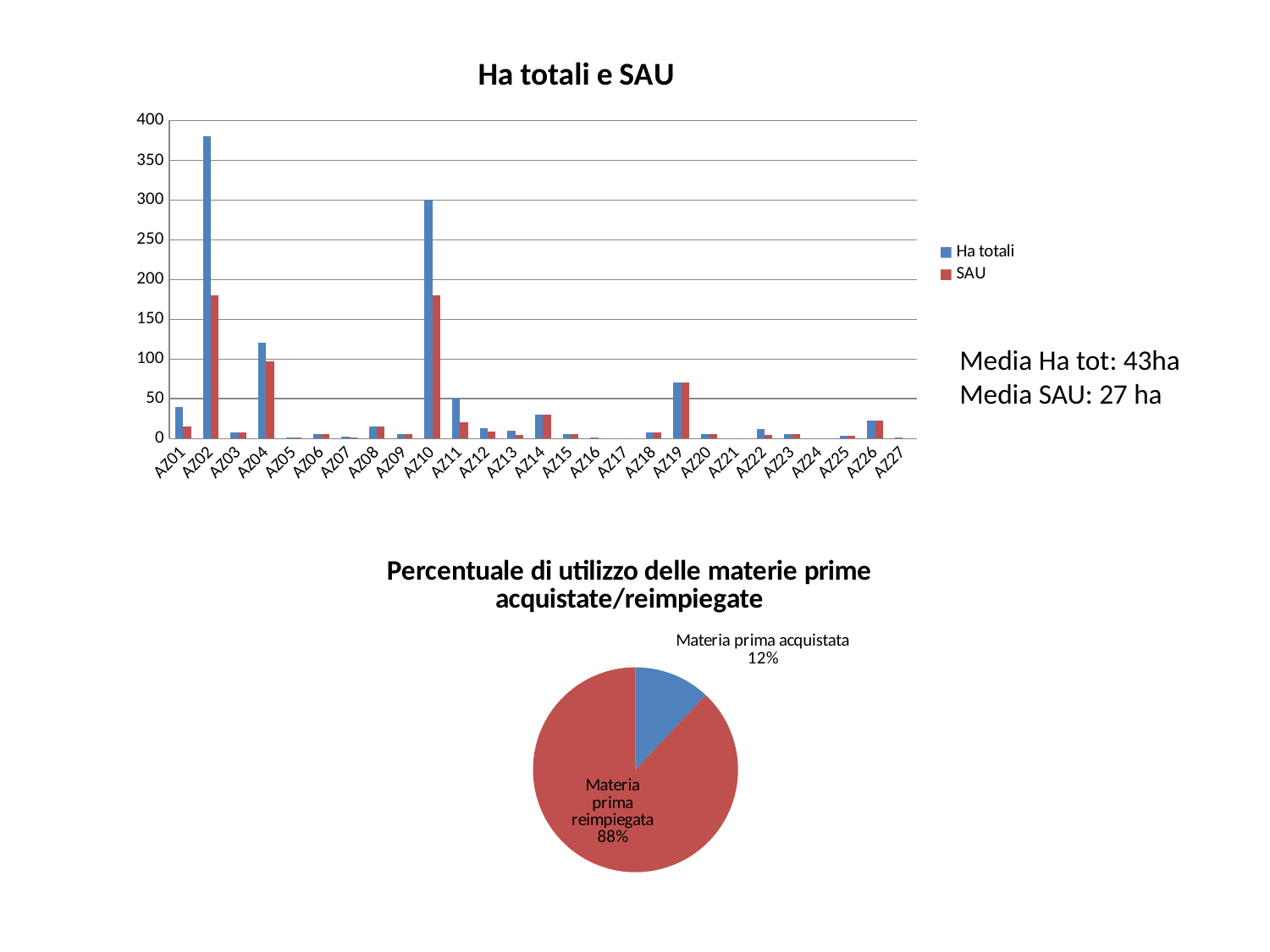
In the chart "Ha totali e SAU", is the SAU value for AZ10 greater or less than 150? greater In the chart "Ha totali e SAU", how many categories (AZ codes) are shown on the x axis? 27 In the pie chart "Percentuale di utilizzo delle materie prime acquistate/reimpiegate", what is the value for Materia prima acquistata? 12% In the pie chart "Percentuale di utilizzo delle materie prime acquistate/reimpiegate", what share is Materia prima reimpiegata? 88% In the chart "Ha totali e SAU", is the Ha totali value for AZ02 greater or less than 350? greater In the chart "Ha totali e SAU", which category has the highest Ha totali value? AZ02 In the chart "Ha totali e SAU", how many series does the legend list? 2 In the chart "Ha totali e SAU", which has the larger Ha totali value, AZ02 or AZ10? AZ02 What kind of chart is the top chart titled "Ha totali e SAU"? bar chart What kind of chart is the bottom chart on the slide? pie chart In the chart "Ha totali e SAU", is the Ha totali value for AZ04 greater or less than 100? greater In the chart "Ha totali e SAU", what are the two legend entries? Ha totali, SAU